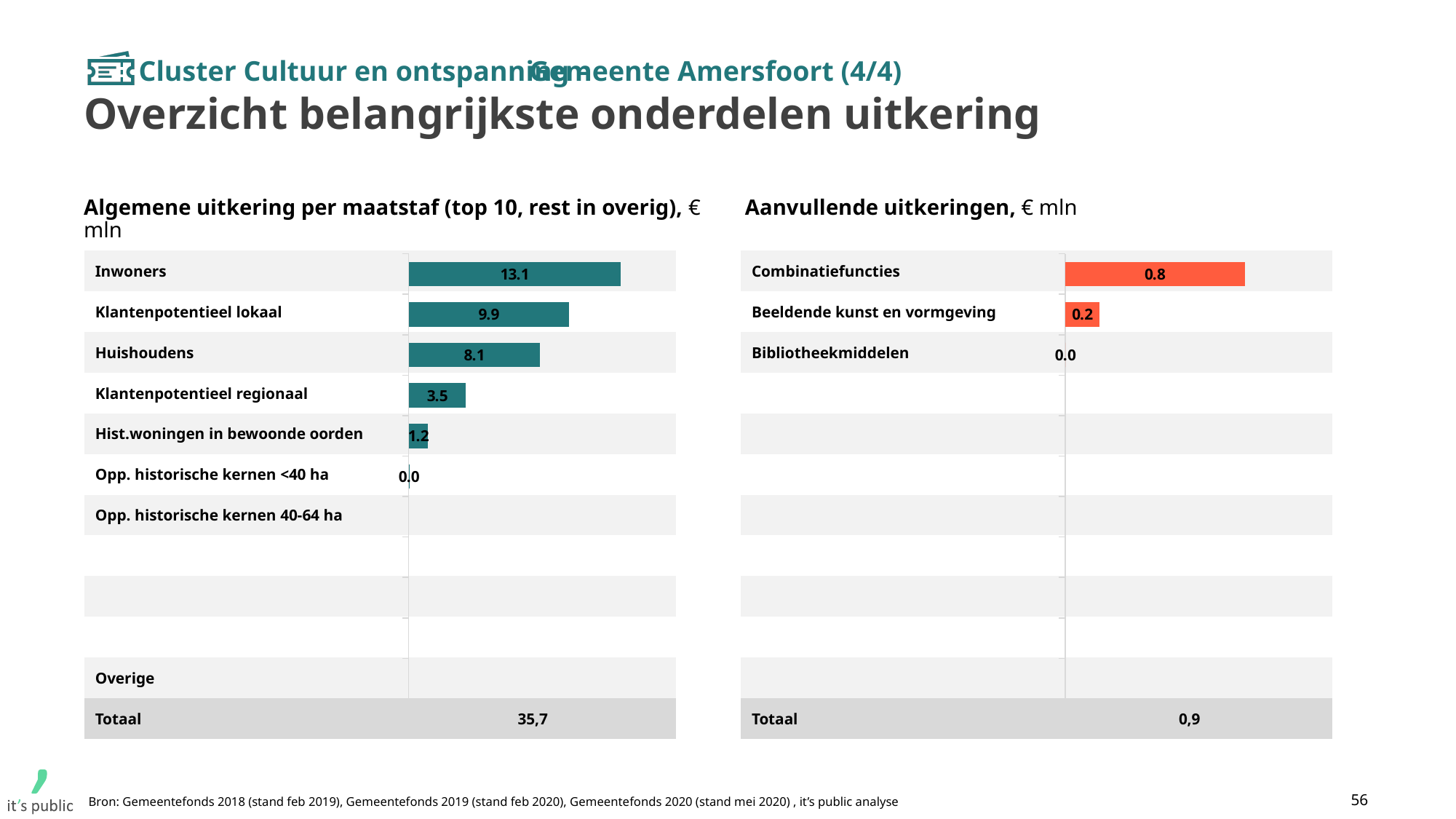
In the 'Algemene uitkering per maatstaf' chart, what is the difference between Inwoners and Klantenpotentieel lokaal? 3.2 In the 'Algemene uitkering per maatstaf' chart, what is the value for Huishoudens? 8.1 In the 'Algemene uitkering per maatstaf' chart, what is the value for Inwoners? 13.1 In the 'Aanvullende uitkeringen' chart, what is the value for Combinatiefuncties? 0.8 In the 'Algemene uitkering per maatstaf' chart, which is larger: Huishoudens or Klantenpotentieel regionaal? Huishoudens In the 'Algemene uitkering per maatstaf' chart, what is the value for Klantenpotentieel regionaal? 3.5 In the 'Aanvullende uitkeringen' chart, which category has the lowest value? Bibliotheekmiddelen What kind of chart is the 'Aanvullende uitkeringen' chart? Bar chart In the 'Aanvullende uitkeringen' chart, what is the value for Beeldende kunst en vormgeving? 0.2 In the 'Algemene uitkering per maatstaf' chart, what is the Totaal shown at the bottom? 35,7 In the 'Aanvullende uitkeringen' chart, what is the Totaal shown at the bottom? 0,9 In the 'Algemene uitkering per maatstaf' chart, which category has the highest value? Inwoners